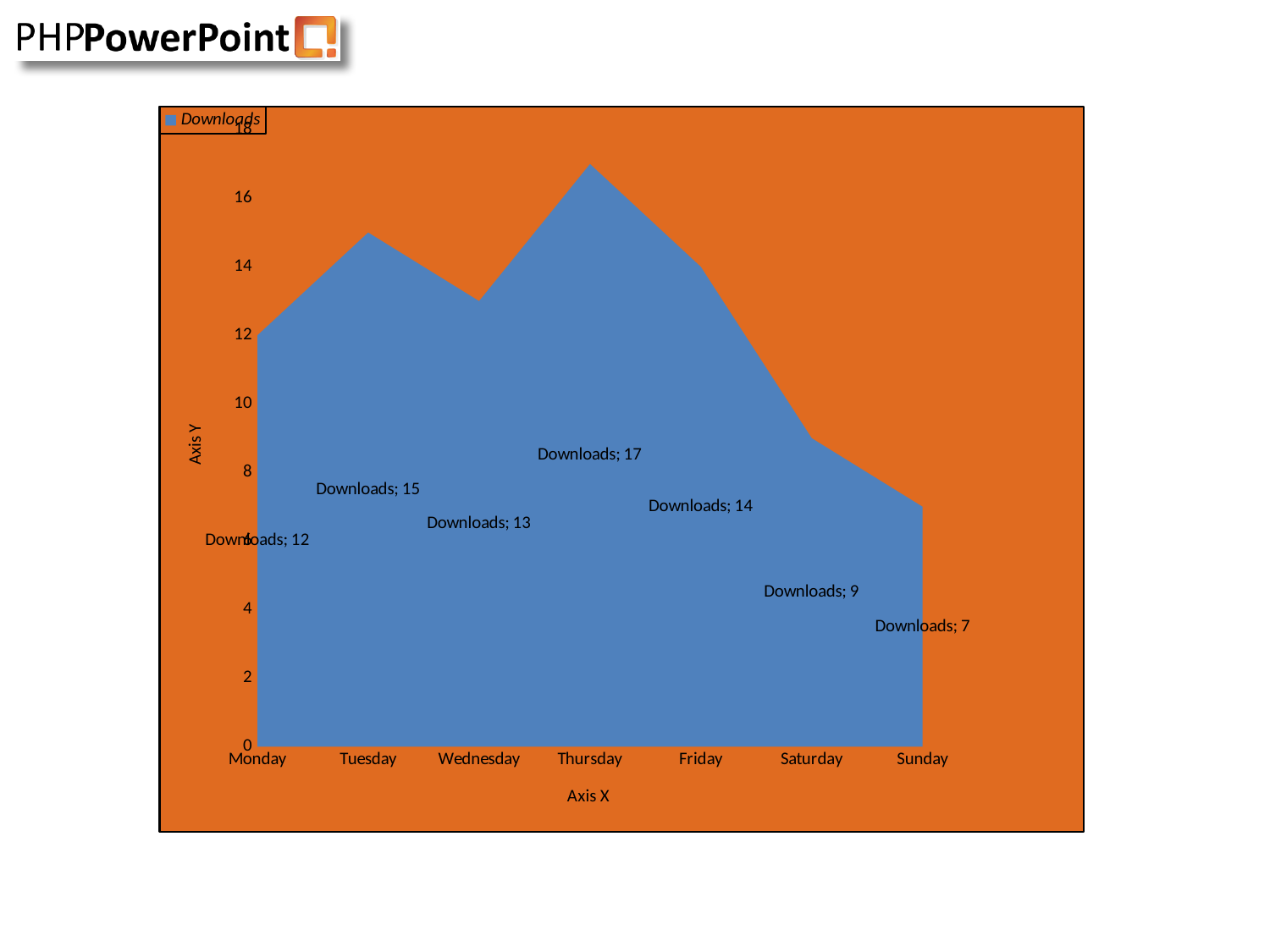
What is the Downloads value for Sunday? 7 Is the Downloads value for Saturday greater or less than 10? less What is the title of the vertical axis? Axis Y How many days are shown on the x axis? 7 What kind of chart is shown on the slide? area chart Which has a larger Downloads value, Tuesday or Friday? Tuesday What is the Downloads value for Tuesday? 15 How many series does the legend list? 1 What is the difference between the Downloads values for Thursday and Sunday? 10 Which day has the lowest Downloads value? Sunday What is the Downloads value for Thursday? 17 Which day has the highest Downloads value? Thursday